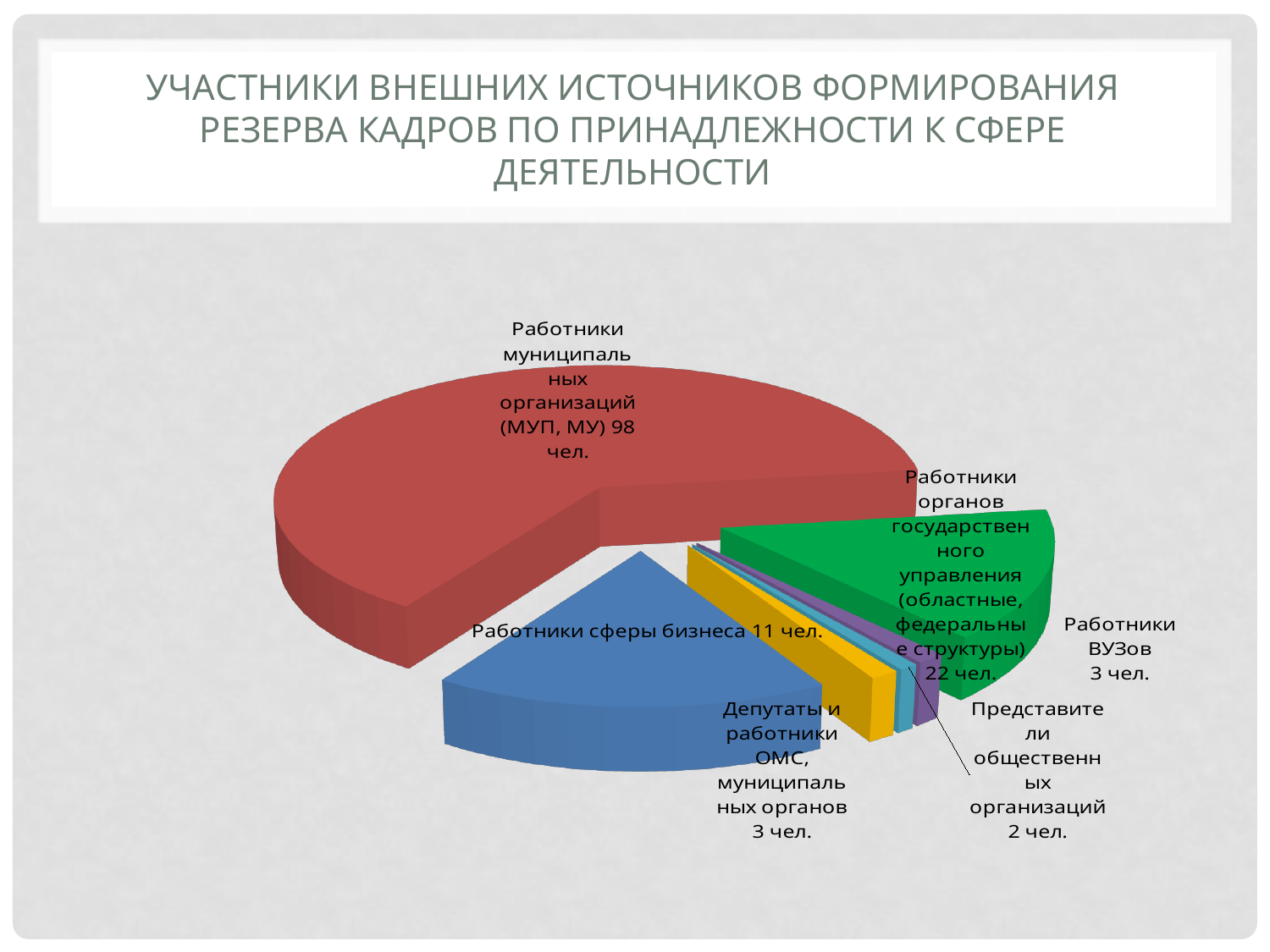
How many people are in the category Работники органов государственного управления (областные, федеральные структуры)? 22 чел. How many people are in the category Работники ВУЗов? 3 чел. How many people are in the category Работники муниципальных организаций (МУП, МУ)? 98 чел. How many people are in the category Работники сферы бизнеса? 11 чел. What is the difference between the number of Работники муниципальных организаций (МУП, МУ) and Работники органов государственного управления? 76 чел. What kind of chart is shown on the slide? pie chart What is the total number of people across all slices of the pie chart? 139 чел. How many categories (slices) does the pie chart have? 6 Which category has the largest slice of the pie? Работники муниципальных организаций (МУП, МУ) Which category has the smallest slice of the pie? Представители общественных организаций How many people are in the category Представители общественных организаций? 2 чел.